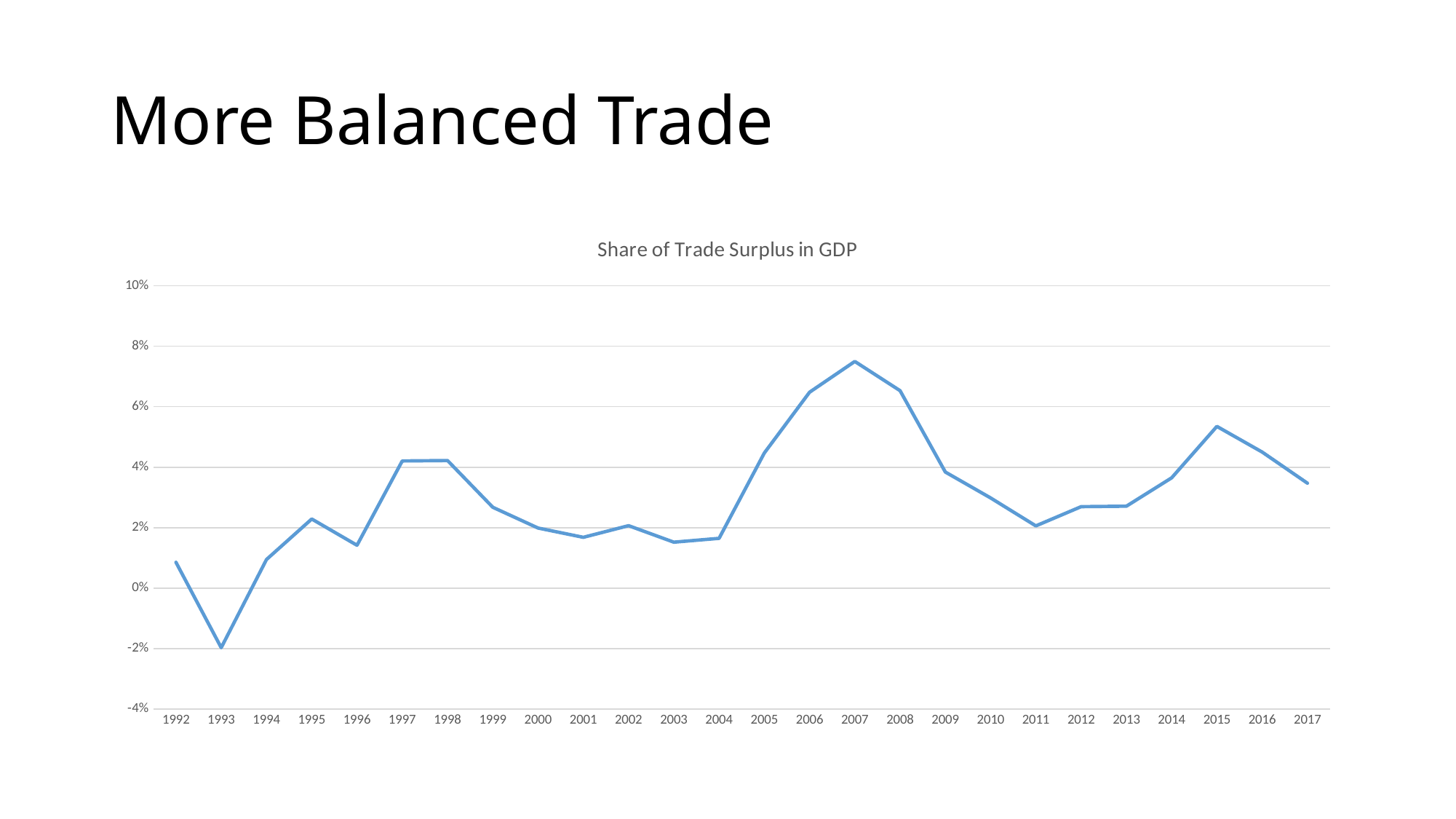
Is the value for 2015 greater or less than 4%? greater Is the value for 2007 greater or less than 6%? greater Which year has the lowest share of trade surplus in GDP? 1993 Does the share of trade surplus in GDP rise or fall from 2011 to 2015? Rise How many years are plotted on the x axis? 26 Is the value for 2003 greater or less than 2%? less What kind of chart is shown on the slide? Line chart Which year has the highest share of trade surplus in GDP? 2007 What is the title of the chart? Share of Trade Surplus in GDP Does the share of trade surplus in GDP rise or fall from 2007 to 2011? Fall Which year has the larger value, 2007 or 2015? 2007